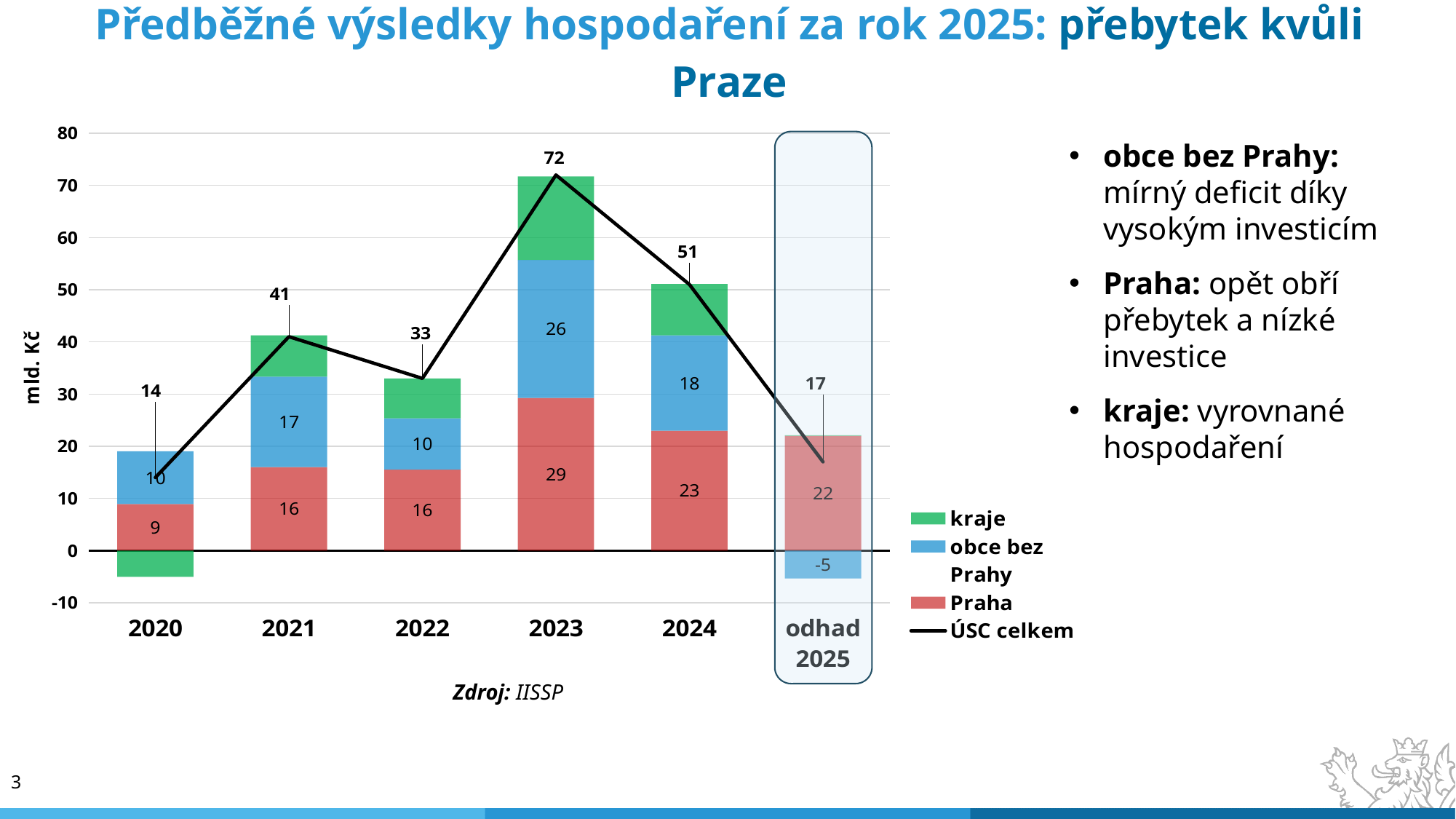
In which year is ÚSC celkem lowest? 2020 What is the label of the y axis? mld. Kč What is the value of ÚSC celkem in 2021? 41 How many series does the legend list? 4 What is the value for obce bez Prahy in 2024? 18 What is the value for obce bez Prahy in odhad 2025? -5 In which year is ÚSC celkem highest? 2023 What is the value for Praha in 2023? 29 How many categories are shown on the x axis? 6 Which year has the larger value for obce bez Prahy, 2021 or 2022? 2021 What is the difference between ÚSC celkem in 2023 and in 2024? 21 Is the value for kraje in 2023 greater or less than 10? greater